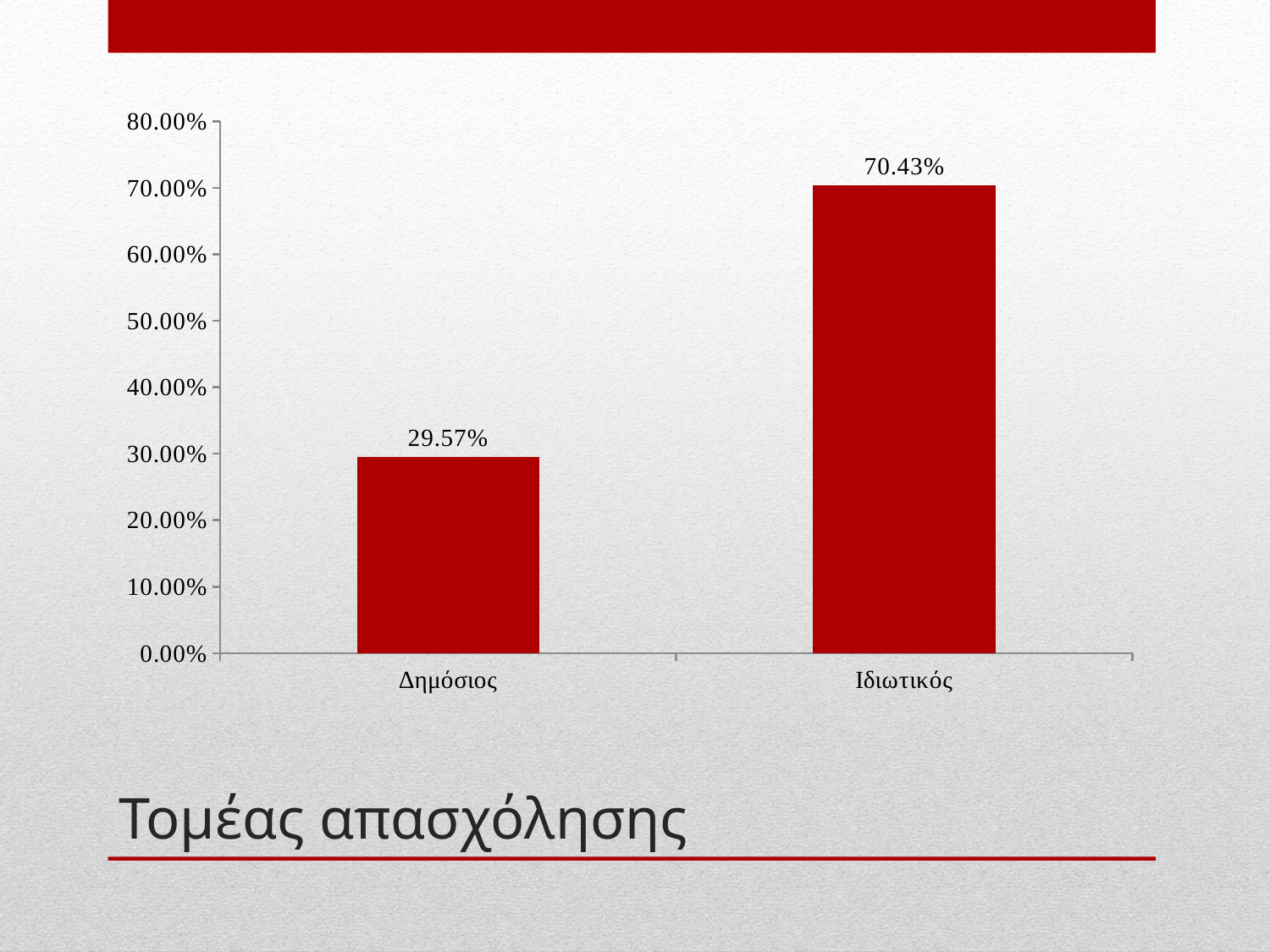
What is the highest value shown on the vertical axis? 80.00% How many categories are shown on the chart? 2 Which category has the lowest value? Δημόσιος What is the value for Δημόσιος? 29.57% What kind of chart is shown on the slide? bar chart What is the value for Ιδιωτικός? 70.43% What is the title of the slide? Τομέας απασχόλησης Which category has the highest value? Ιδιωτικός Is the value for Δημόσιος greater or less than 40.00%? less Which is larger, the value for Δημόσιος or the value for Ιδιωτικός? Ιδιωτικός Is the value for Ιδιωτικός greater or less than 60.00%? greater What is the difference between the values for Ιδιωτικός and Δημόσιος? 40.86%